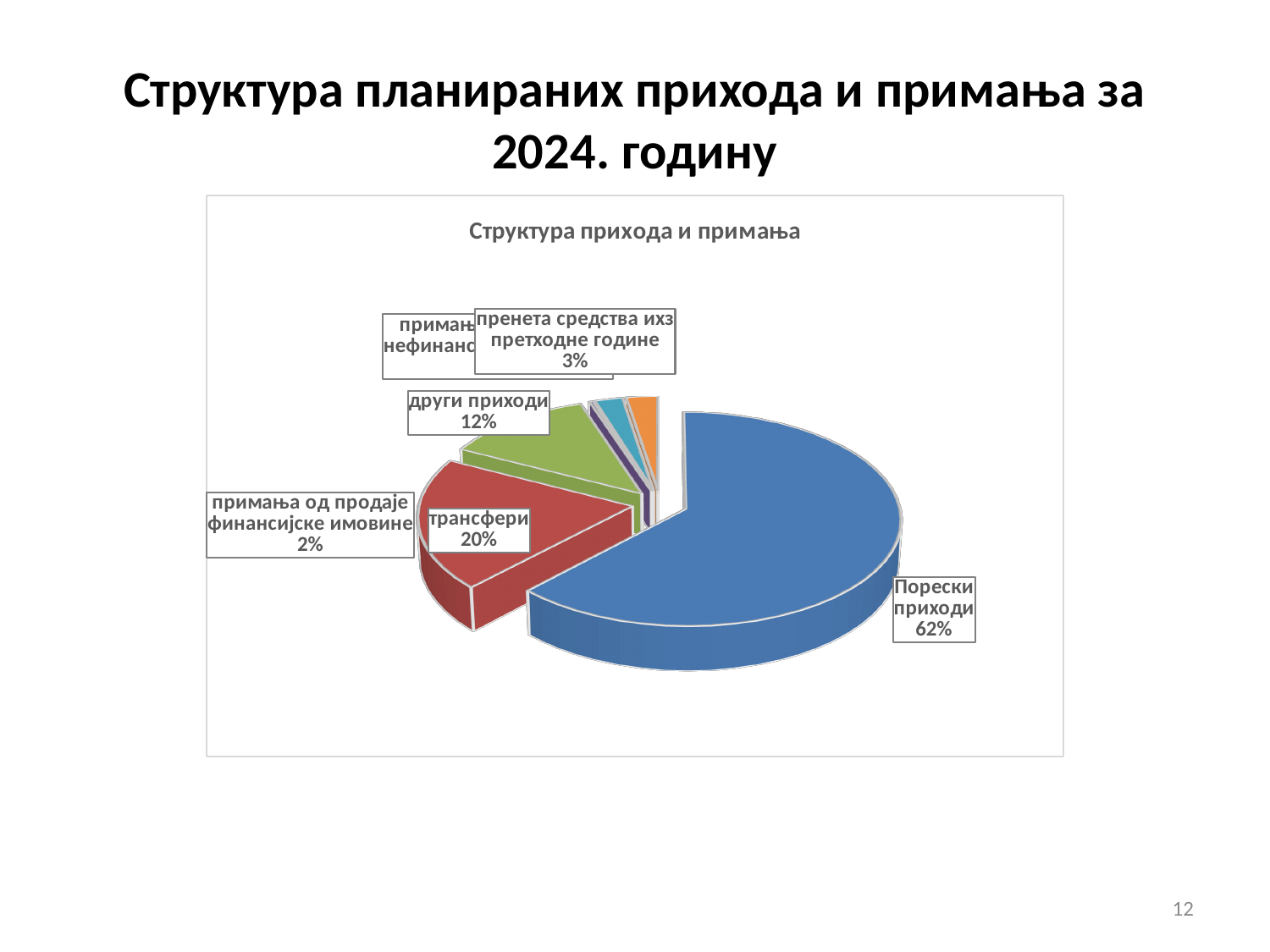
What share of the pie is labelled for Порески приходи? 62% What percentage is shown for трансфери? 20% What kind of chart is shown on the slide? pie chart What is the title of the chart? Структура прихода и примања Which category has the largest slice of the pie? Порески приходи What percentage is shown for примања од продаје финансијске имовине? 2% By how many percentage points does Порески приходи exceed трансфери? 42 percentage points Which is larger, the share for трансфери or the share for други приходи? трансфери By how many percentage points does други приходи exceed пренета средства из претходне године? 9 percentage points What percentage is shown for други приходи? 12% How many slices does the pie chart have? 6 What percentage is shown for пренета средства из претходне године? 3%